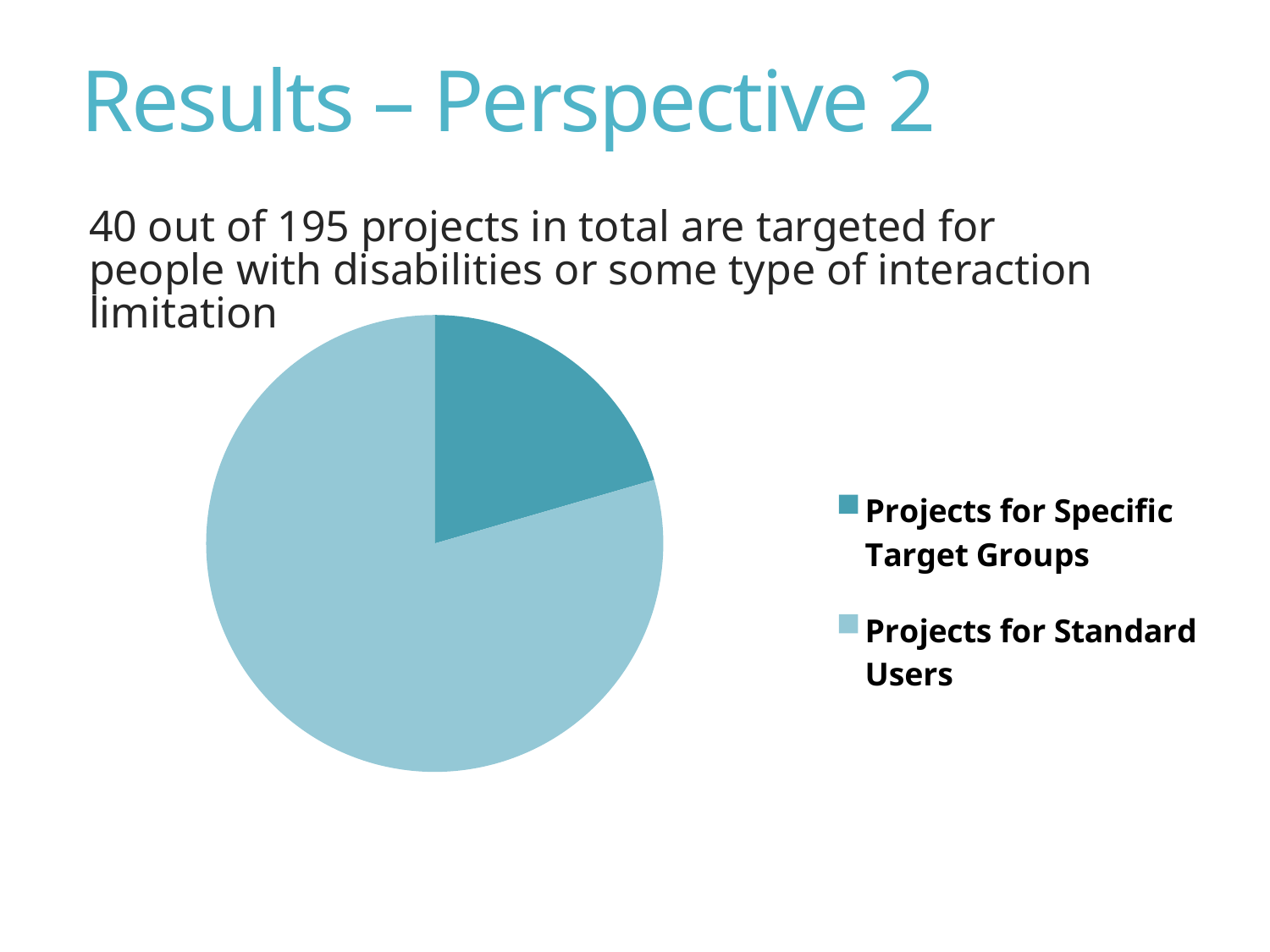
What kind of chart is shown on the slide? Pie chart Which slice is larger: Projects for Specific Target Groups or Projects for Standard Users? Projects for Standard Users What is the first entry listed in the legend of the pie chart? Projects for Specific Target Groups Does the slice for Projects for Specific Target Groups cover more or less than half of the pie? less Which category has the smallest slice in the pie chart? Projects for Specific Target Groups How many slices does the pie chart have? 2 Which category has the largest slice in the pie chart? Projects for Standard Users How many entries does the legend of the pie chart list? 2 Which legend entry is shown in the darker teal colour? Projects for Specific Target Groups